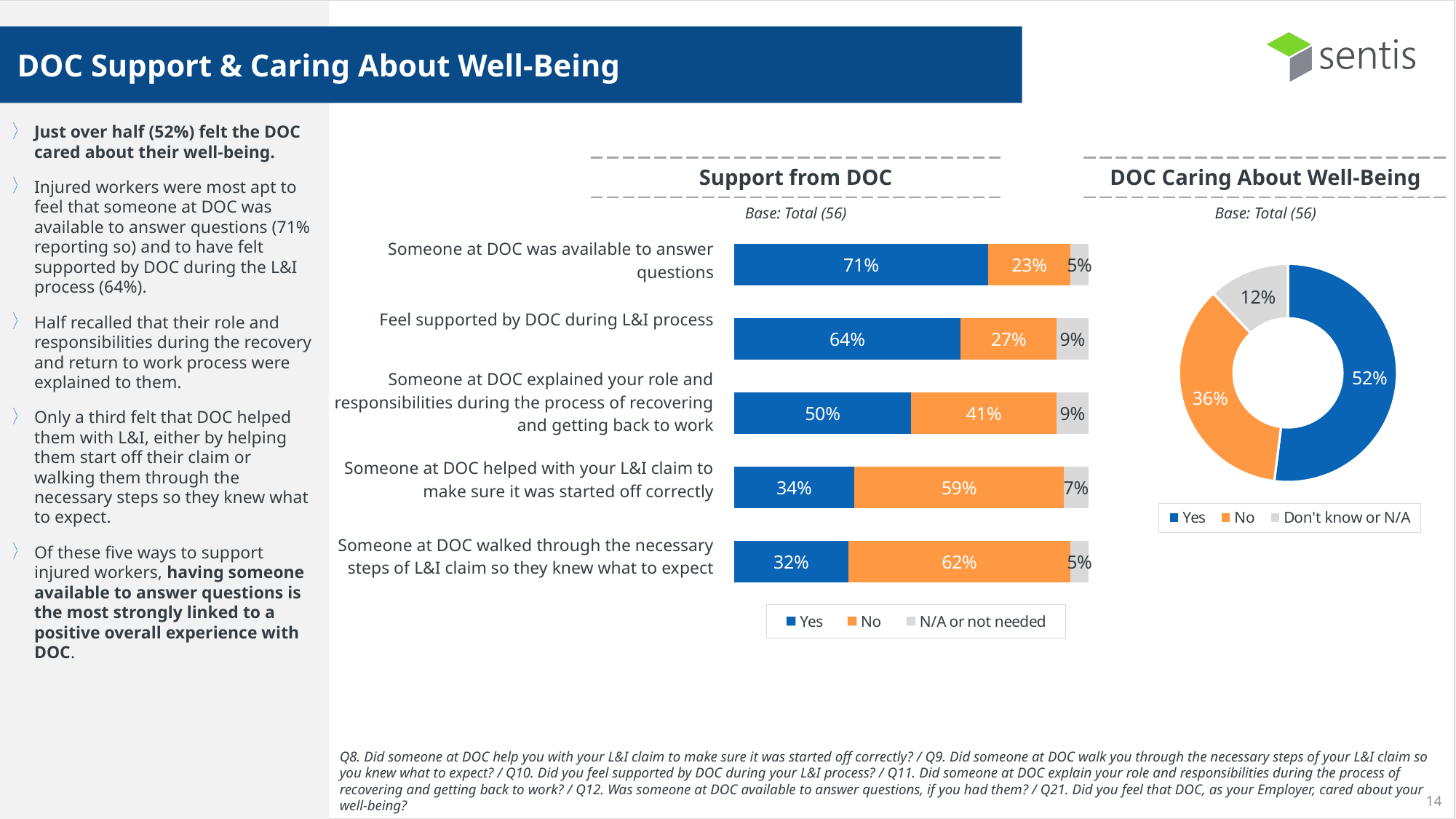
In the 'Support from DOC' chart, which is larger: the No percentage for 'Someone at DOC walked through the necessary steps of L&I claim so they knew what to expect' or the No percentage for 'Someone at DOC helped with your L&I claim to make sure it was started off correctly'? Someone at DOC walked through the necessary steps of L&I claim so they knew what to expect How many items are shown in the 'Support from DOC' chart? 5 In the 'Support from DOC' chart, what percentage answered Yes to 'Someone at DOC was available to answer questions'? 71% In the 'DOC Caring About Well-Being' chart, what share of respondents answered Yes? 52% In the 'Support from DOC' chart, which item has the lowest Yes percentage? Someone at DOC walked through the necessary steps of L&I claim so they knew what to expect What kind of chart is the 'Support from DOC' chart? Stacked bar chart In the 'Support from DOC' chart, what is the difference between the Yes percentages for 'Feel supported by DOC during L&I process' and 'Someone at DOC explained your role and responsibilities during the process of recovering and getting back to work'? 14% In the 'DOC Caring About Well-Being' chart, what percentage answered 'Don't know or N/A'? 12% What kind of chart is the 'DOC Caring About Well-Being' chart? Doughnut chart In the 'Support from DOC' chart, which item has the highest Yes percentage? Someone at DOC was available to answer questions How many series does the legend of the 'Support from DOC' chart list? 3 In the 'Support from DOC' chart, what percentage answered No to 'Someone at DOC helped with your L&I claim to make sure it was started off correctly'? 59%